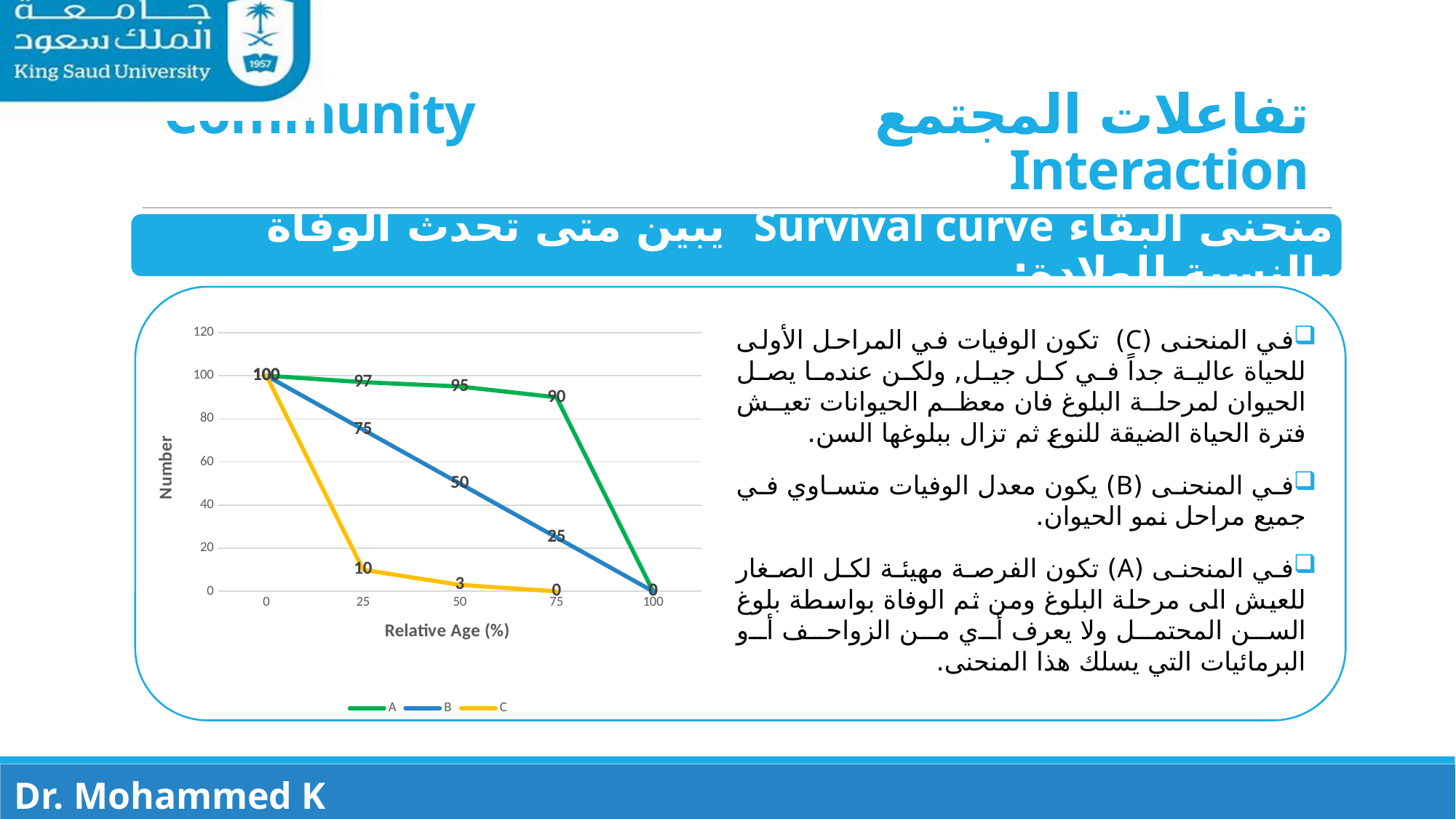
What is the value of series A at relative age 50%? 95 What is the difference between series A and series B at relative age 50%? 45 What is the value of series A at relative age 75%? 90 Do the values of series B rise or fall as relative age increases? fall What is the value of series B at relative age 75%? 25 What is the label of the y axis? Number How many series does the legend list? 3 Which series has the lowest value at relative age 50%? C Which series has the higher value at relative age 25%, A or C? A What kind of chart is shown on the slide? line chart What is the label of the x axis? Relative Age (%) What is the value of series C at relative age 25%? 10